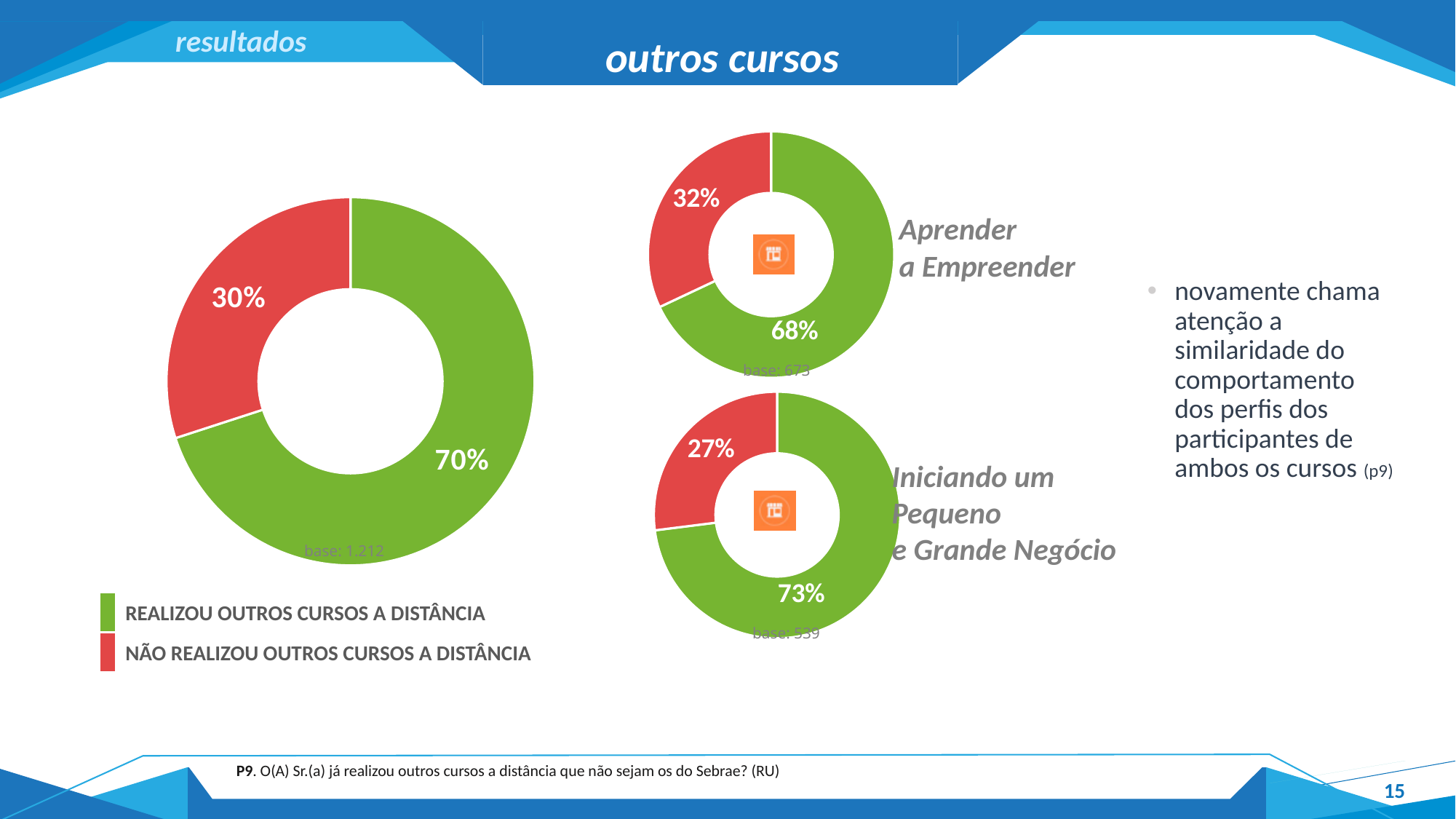
In the 'Iniciando um Pequeno e Grande Negócio' donut chart, what percentage is shown for the red slice (não realizou outros cursos a distância)? 27% In the large donut chart on the left, what share of respondents 'não realizou outros cursos a distância'? 30% What type of chart is used on this slide? Donut (pie) chart In the large donut chart on the left, what share of respondents 'realizou outros cursos a distância'? 70% What colour represents 'não realizou outros cursos a distância' in the charts? Red In the 'Aprender a Empreender' donut chart, what percentage is shown for the red slice (não realizou outros cursos a distância)? 32% In the 'Aprender a Empreender' donut chart, which category is the largest? Realizou outros cursos a distância In the 'Iniciando um Pequeno e Grande Negócio' donut chart, what percentage is shown for the green slice (realizou outros cursos a distância)? 73% Which course has the larger share of participants who 'realizou outros cursos a distância': 'Aprender a Empreender' or 'Iniciando um Pequeno e Grande Negócio'? Iniciando um Pequeno e Grande Negócio In the large donut chart on the left, what is the difference between the 'realizou' and 'não realizou' shares? 40 percentage points In the 'Aprender a Empreender' donut chart, what percentage is shown for the green slice (realizou outros cursos a distância)? 68% How many categories does the legend list? 2